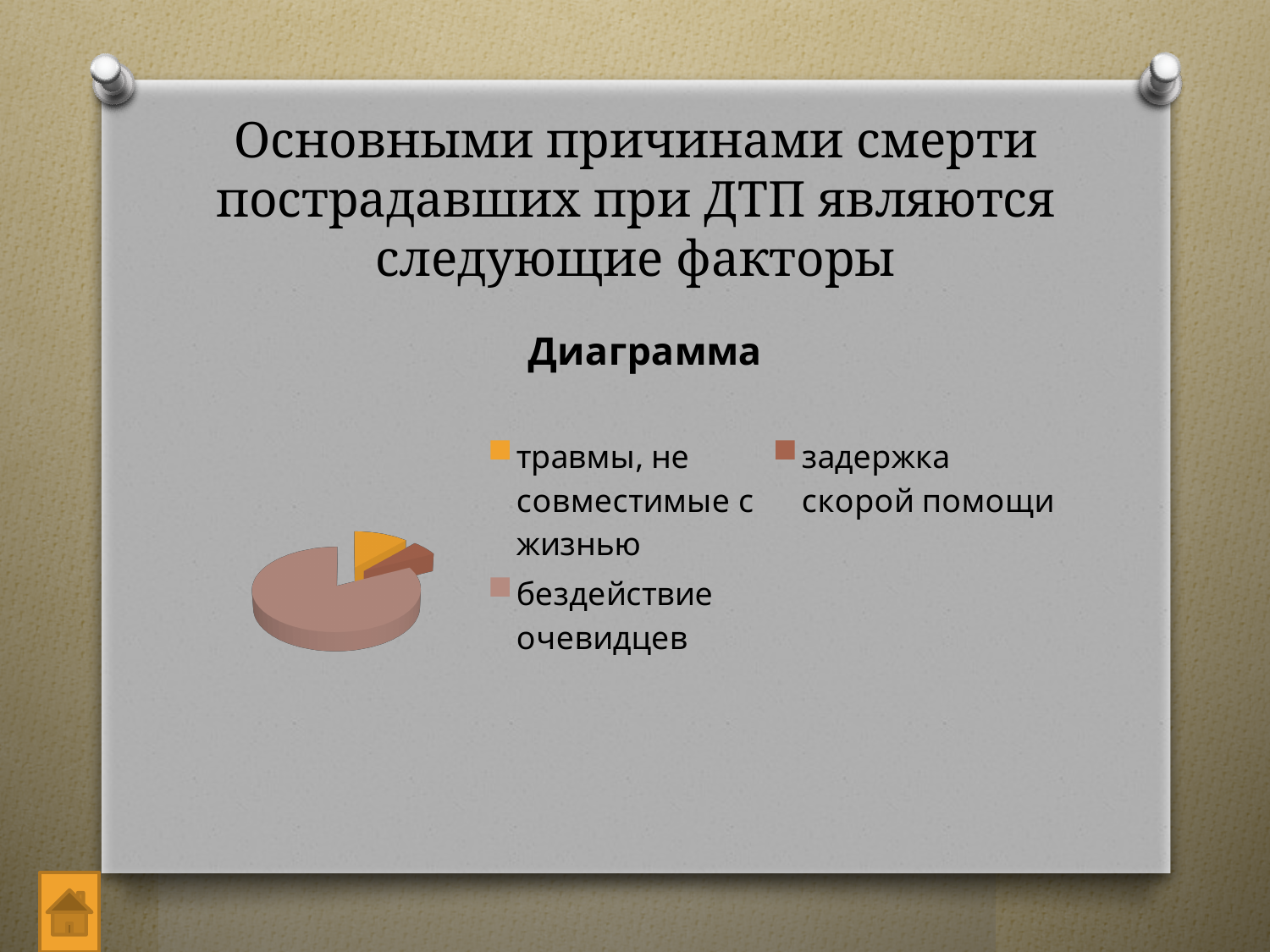
Which slice is larger: "бездействие очевидцев" or "задержка скорой помощи"? бездействие очевидцев Which slice is larger: "бездействие очевидцев" or "травмы, не совместимые с жизнью"? бездействие очевидцев How many categories does the pie chart show? 3 What kind of chart is shown on the slide? pie chart What is the title of the chart? Диаграмма How many entries does the chart legend list? 3 Which colour represents "травмы, не совместимые с жизнью" in the chart? orange Which category has the largest slice of the pie? бездействие очевидцев